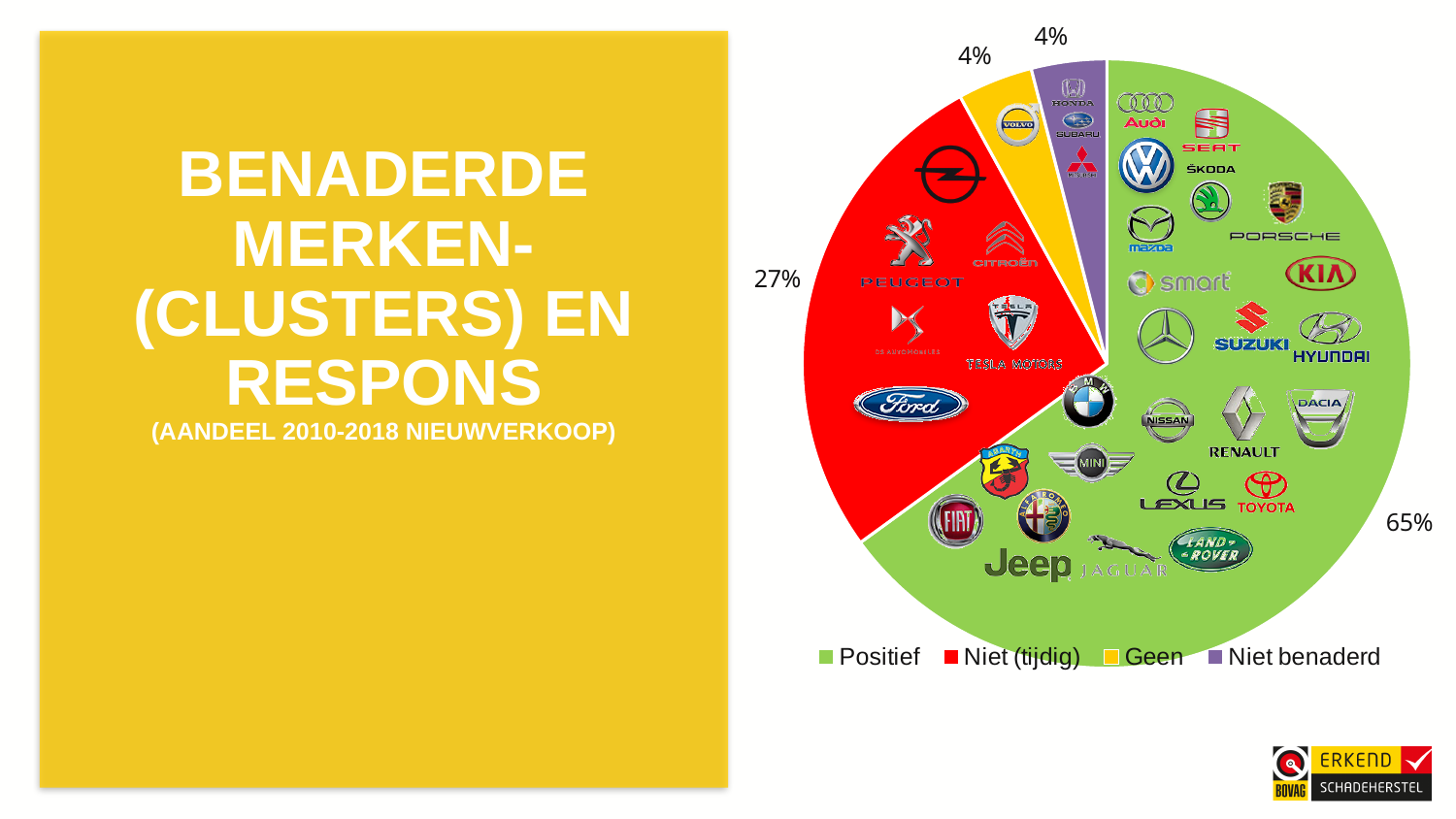
What percentage is shown for the Niet benaderd slice? 4% What colour is the Niet (tijdig) slice? Red How many entries does the legend list? 4 How many slices does the pie chart have? 4 What share of the pie does the Positief slice represent? 65% Which legend entry is shown in purple? Niet benaderd What kind of chart is shown on the slide? Pie chart What percentage is shown for the Geen slice? 4% What is the difference in percentage points between the Positief and Niet (tijdig) slices? 38 Which category has the largest slice of the pie? Positief Which slice is larger, Niet (tijdig) or Geen? Niet (tijdig) What percentage is shown for the Niet (tijdig) slice? 27%